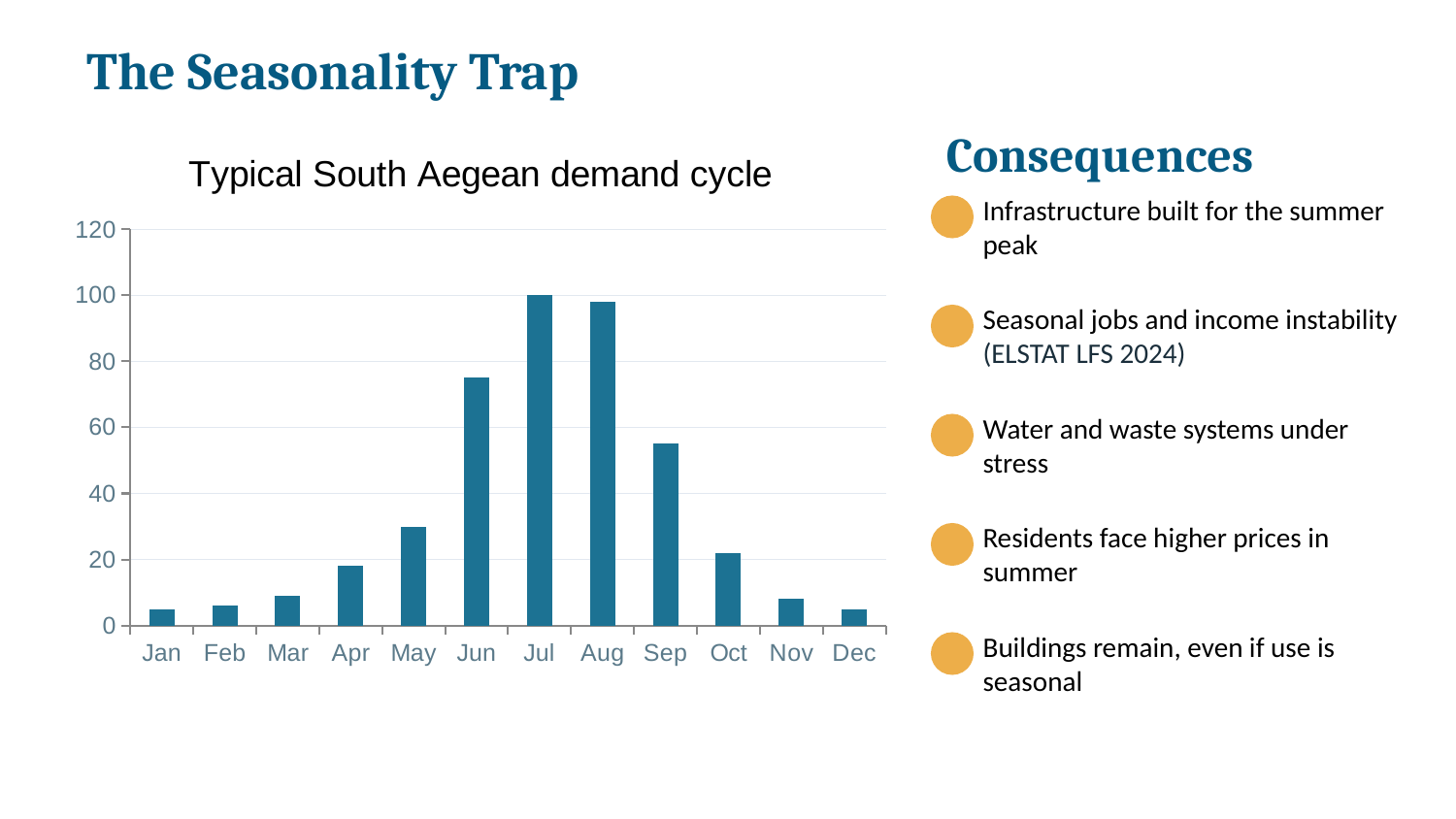
Which has a larger value, Jun or Sep? Jun Is the value for Sep greater or less than 40? greater What is the title of the chart? Typical South Aegean demand cycle Is the value for Nov greater or less than 20? less Is the value for Jun greater or less than 60? greater Do the values rise or fall from Jan to Jul? Rise How many months are shown on the x axis of the chart? 12 What type of chart is shown on the slide? Bar chart Do the values rise or fall from Aug to Dec? Fall Which has a larger value, May or Aug? Aug What is the value for Jul in the chart? 100